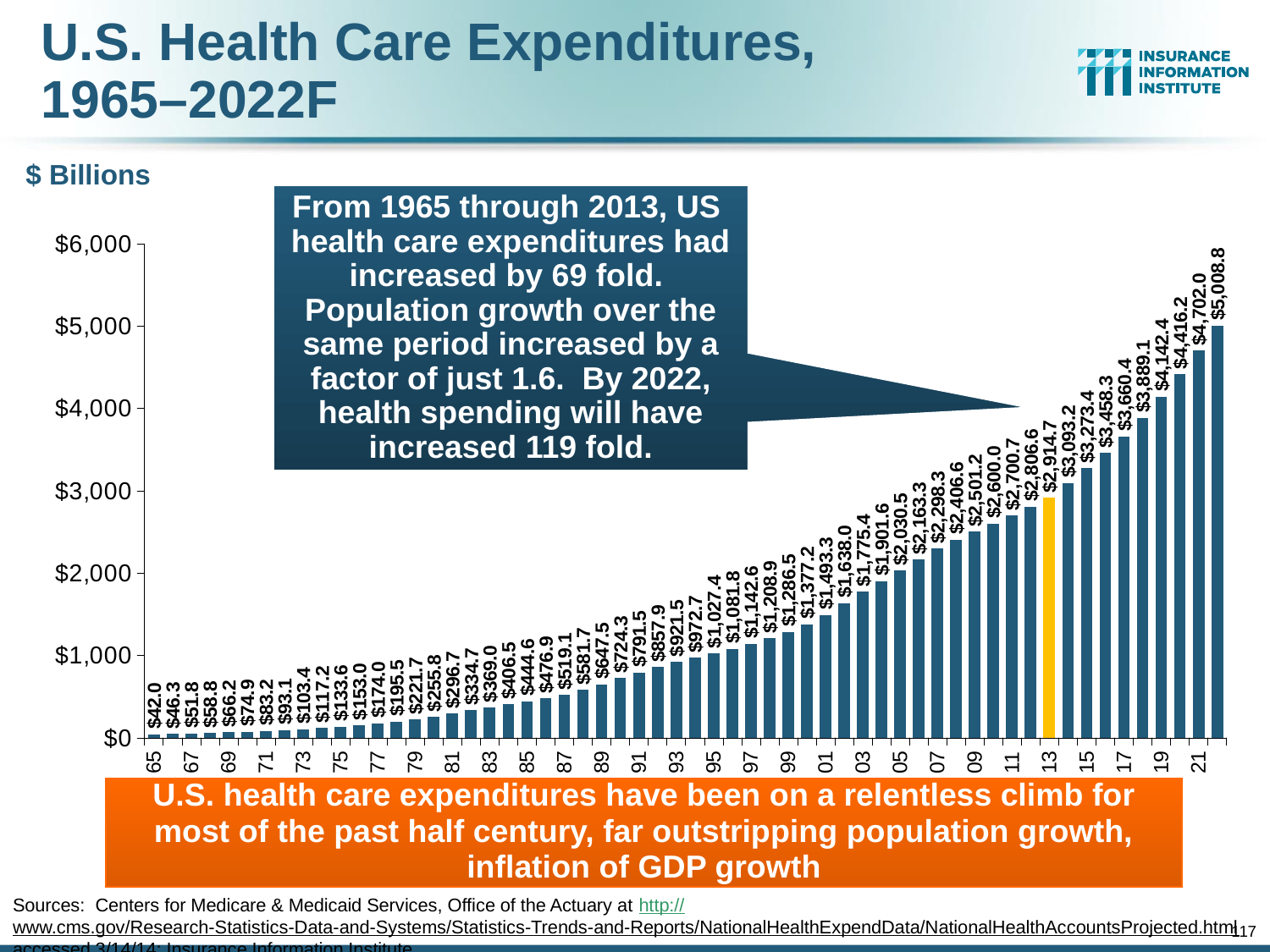
What is the difference between the 2022 value and the 2021 value? $306.8 Do the values generally rise or fall from 1965 to 2022? Rise What kind of chart is shown on the slide? Bar chart Is the value for 2013 greater or less than $3,000? less What is the lowest value shown on the chart, and for which year? $42.0 in 1965 What is the difference between the 2022 value and the 2013 value? $2,094.1 What is the value shown for 1965? $42.0 What is the value shown for 2021? $4,702.0 What is the highest value shown on the chart, and for which year? $5,008.8 in 2022 What is the value of the highlighted (yellow) bar for 2013? $2,914.7 How many bars (years) are plotted on the chart? 58 What unit is indicated for the values on the chart? $ Billions